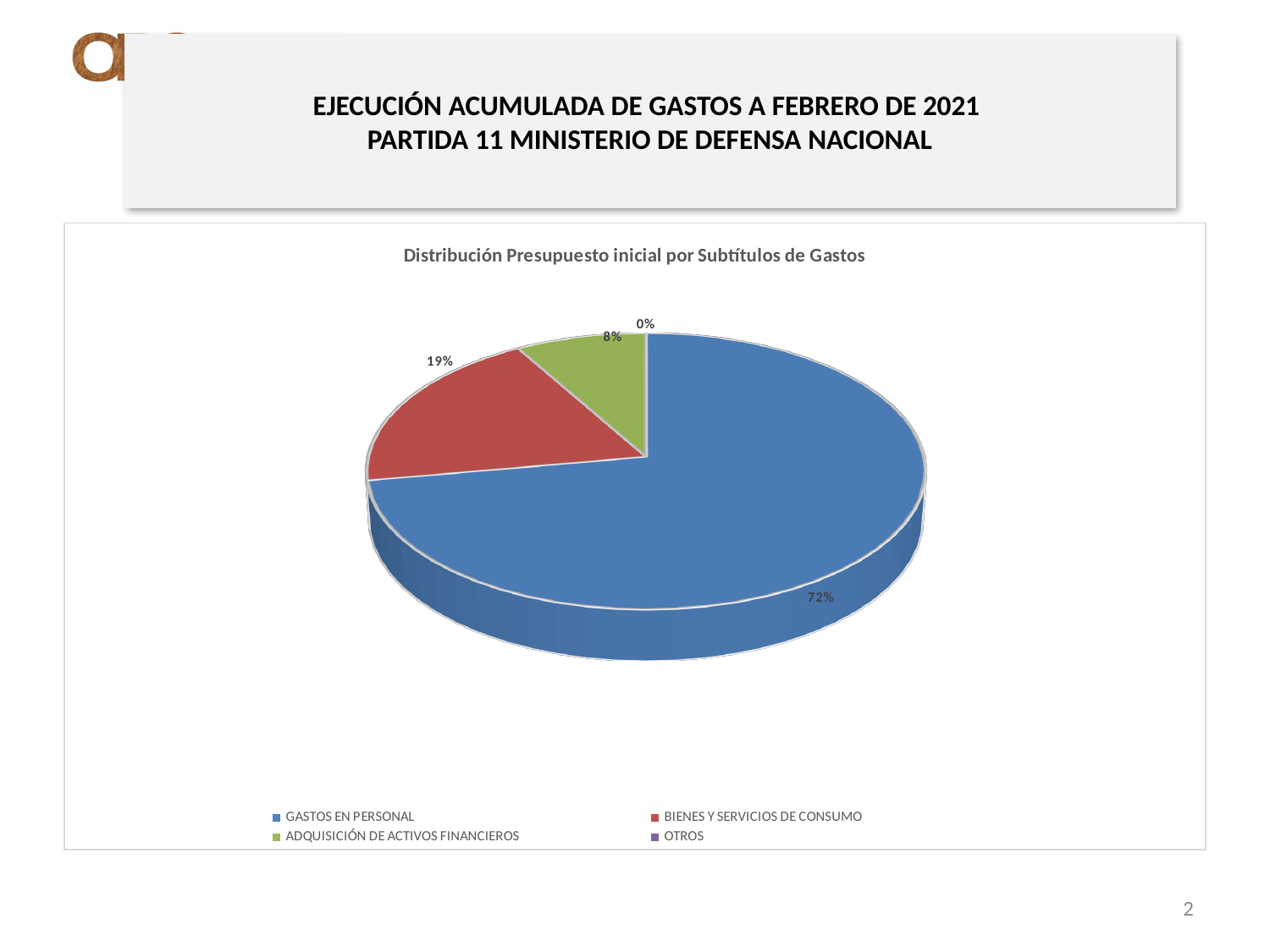
Which category has the largest slice of the pie? GASTOS EN PERSONAL How many categories does the legend list? 4 Which is larger, the share for BIENES Y SERVICIOS DE CONSUMO or the share for ADQUISICIÓN DE ACTIVOS FINANCIEROS? BIENES Y SERVICIOS DE CONSUMO What share of the pie does OTROS represent? 0% What kind of chart is shown on the slide? pie chart What share of the pie does BIENES Y SERVICIOS DE CONSUMO represent? 19% What is the title of the chart? Distribución Presupuesto inicial por Subtítulos de Gastos What share of the pie does ADQUISICIÓN DE ACTIVOS FINANCIEROS represent? 8% What is the difference in percentage points between GASTOS EN PERSONAL and BIENES Y SERVICIOS DE CONSUMO? 53 Which category has the smallest slice of the pie? OTROS What colour is the slice for GASTOS EN PERSONAL? blue